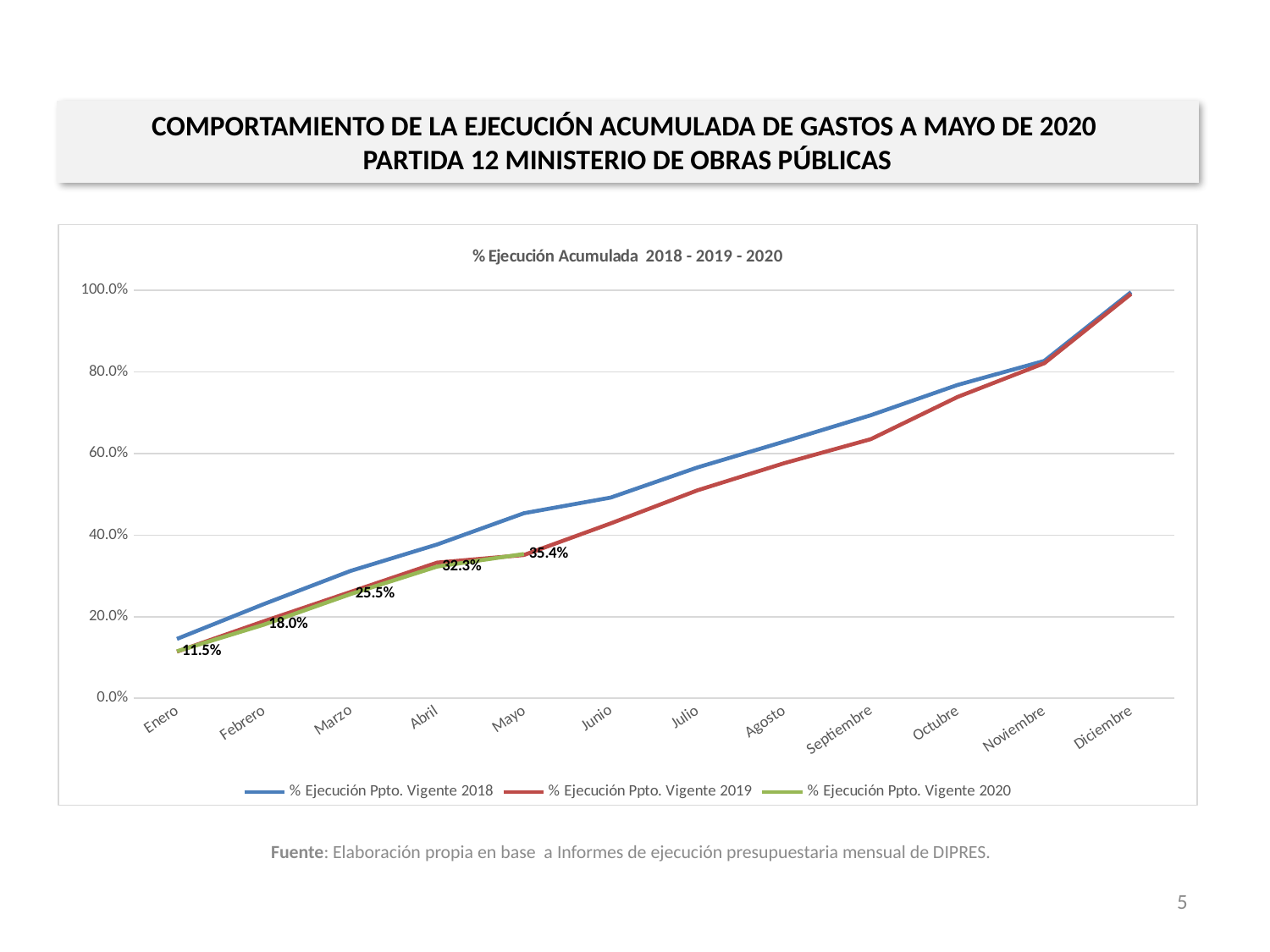
Is the value for % Ejecución Ppto. Vigente 2019 in Septiembre greater or less than 60.0%? greater What is the value for % Ejecución Ppto. Vigente 2020 in Mayo? 35.4% In Mayo, which series has the larger value, 2018 or 2019? 2018 How many series does the legend list? 3 What is the value for % Ejecución Ppto. Vigente 2020 in Marzo? 25.5% Which month has the highest value for % Ejecución Ppto. Vigente 2020? Mayo What is the difference between the 2020 values for Mayo and Enero? 23.9% What kind of chart is shown on the slide? line chart What is the value for % Ejecución Ppto. Vigente 2020 in Enero? 11.5% How many months are shown along the x axis? 12 Do the values for % Ejecución Ppto. Vigente 2018 rise or fall from Enero to Diciembre? rise Is the value for % Ejecución Ppto. Vigente 2018 in Mayo greater or less than 40.0%? greater